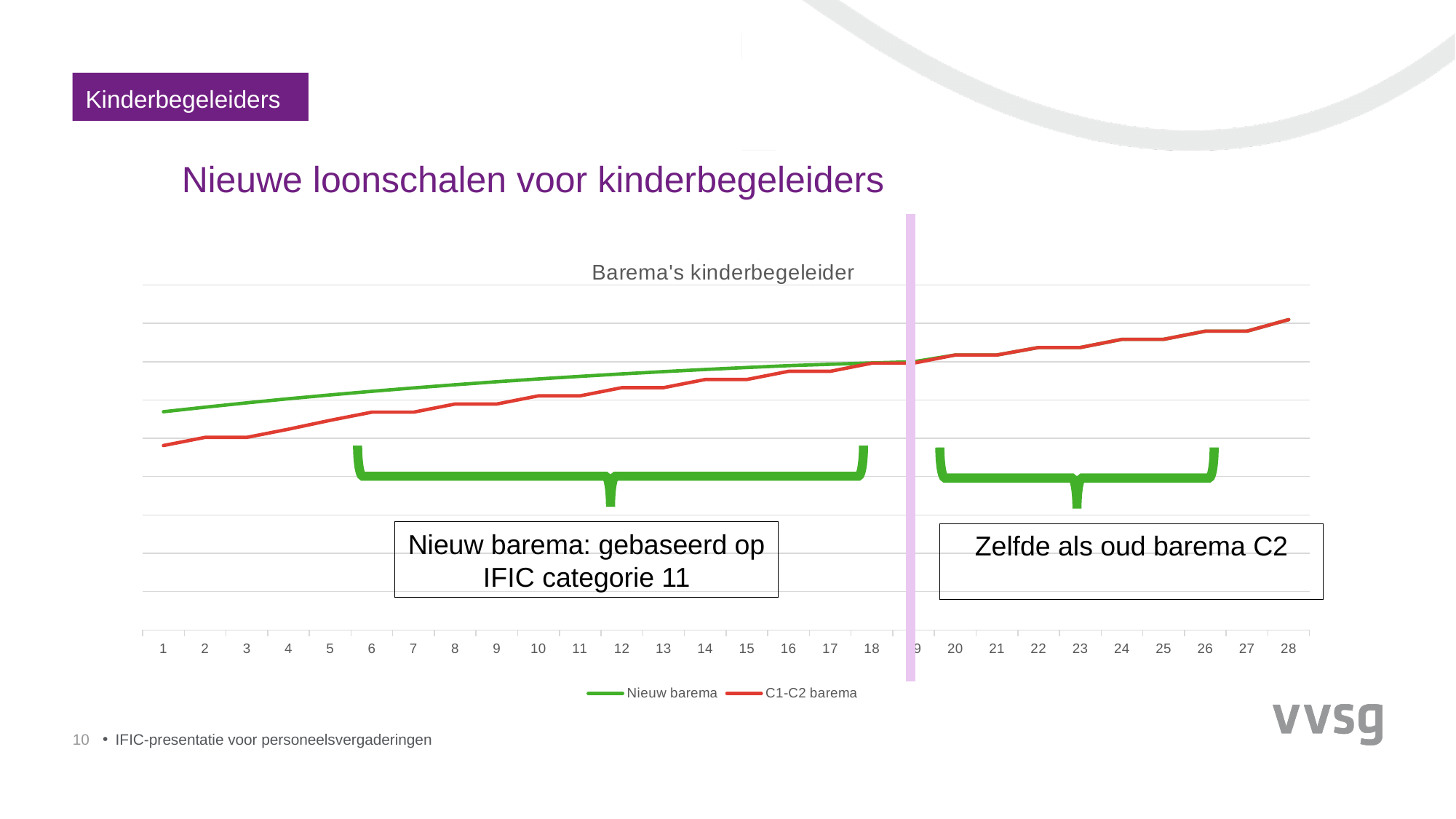
What is the title of the chart? Barema's kinderbegeleider How many points are labelled on the x axis? 28 Does the Nieuw barema line rise or fall along the x axis? rise Does the C1-C2 barema line rise or fall from 1 to 28? rise At which x value is the C1-C2 barema line at its highest? 28 At which x value is the Nieuw barema line at its lowest? 1 What kind of chart is shown on the slide? line chart How many series does the chart legend list? 2 At x = 1, which series has the higher value, Nieuw barema or C1-C2 barema? Nieuw barema At which x value is the C1-C2 barema line at its lowest? 1 Which series is drawn in red? C1-C2 barema At x = 10, which series has the higher value, Nieuw barema or C1-C2 barema? Nieuw barema